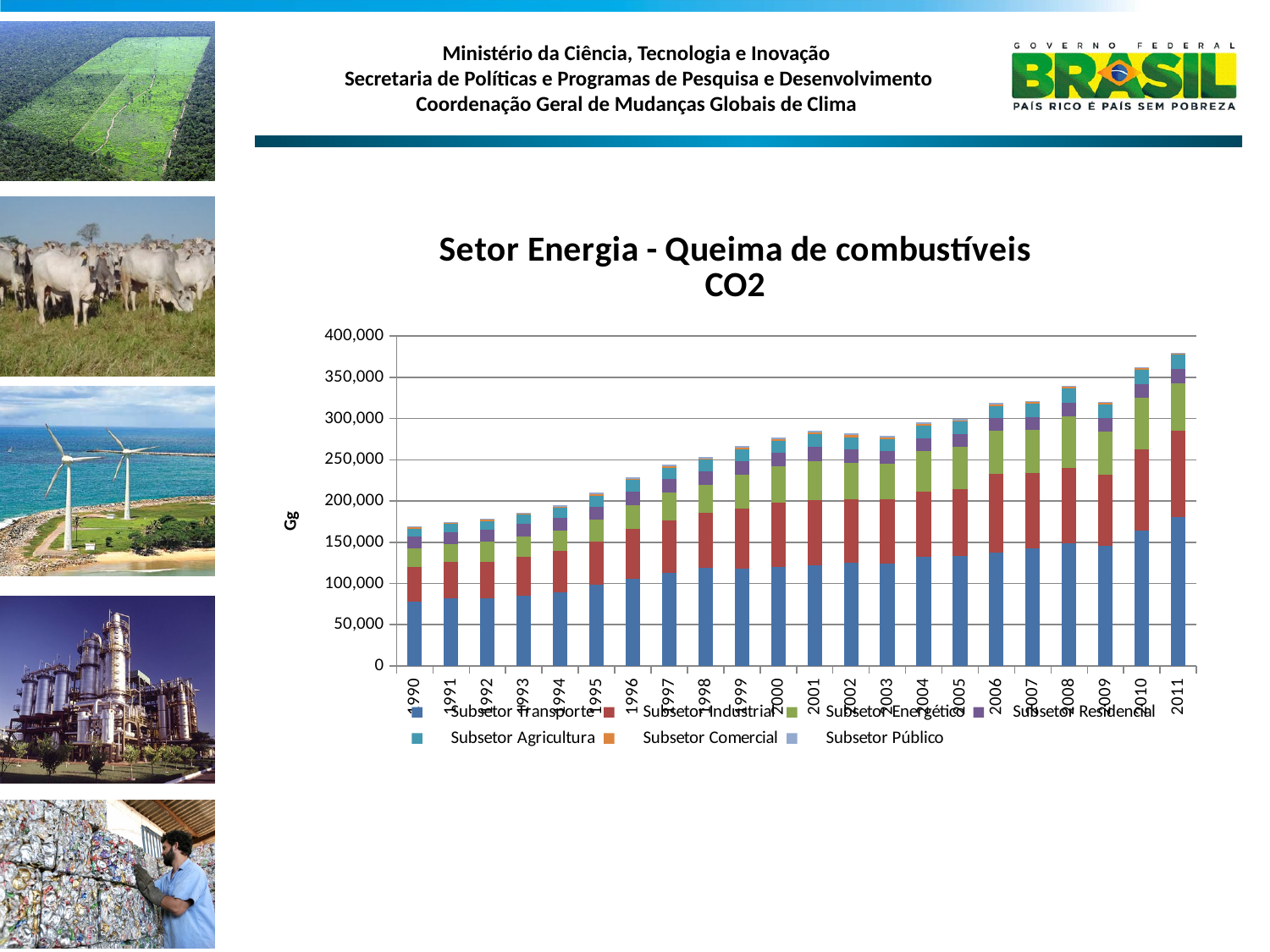
What unit is shown on the y axis label of the chart? Gg What kind of chart is shown on the slide? Stacked bar chart Which year has a larger total stacked bar, 2010 or 2009? 2010 How many years are shown along the x axis of the chart? 22 Which year has the highest total stacked bar? 2011 What is the title of the chart? Setor Energia - Queima de combustíveis CO2 Is the total value for 1990 greater or less than 200,000? less How many series does the chart's legend list? 7 Which year has the lowest total stacked bar? 1990 Is the total value for 2000 greater or less than 250,000? greater Is the total value for 2011 greater or less than 350,000? greater Do the total values generally rise or fall from 1990 to 2011? Rise